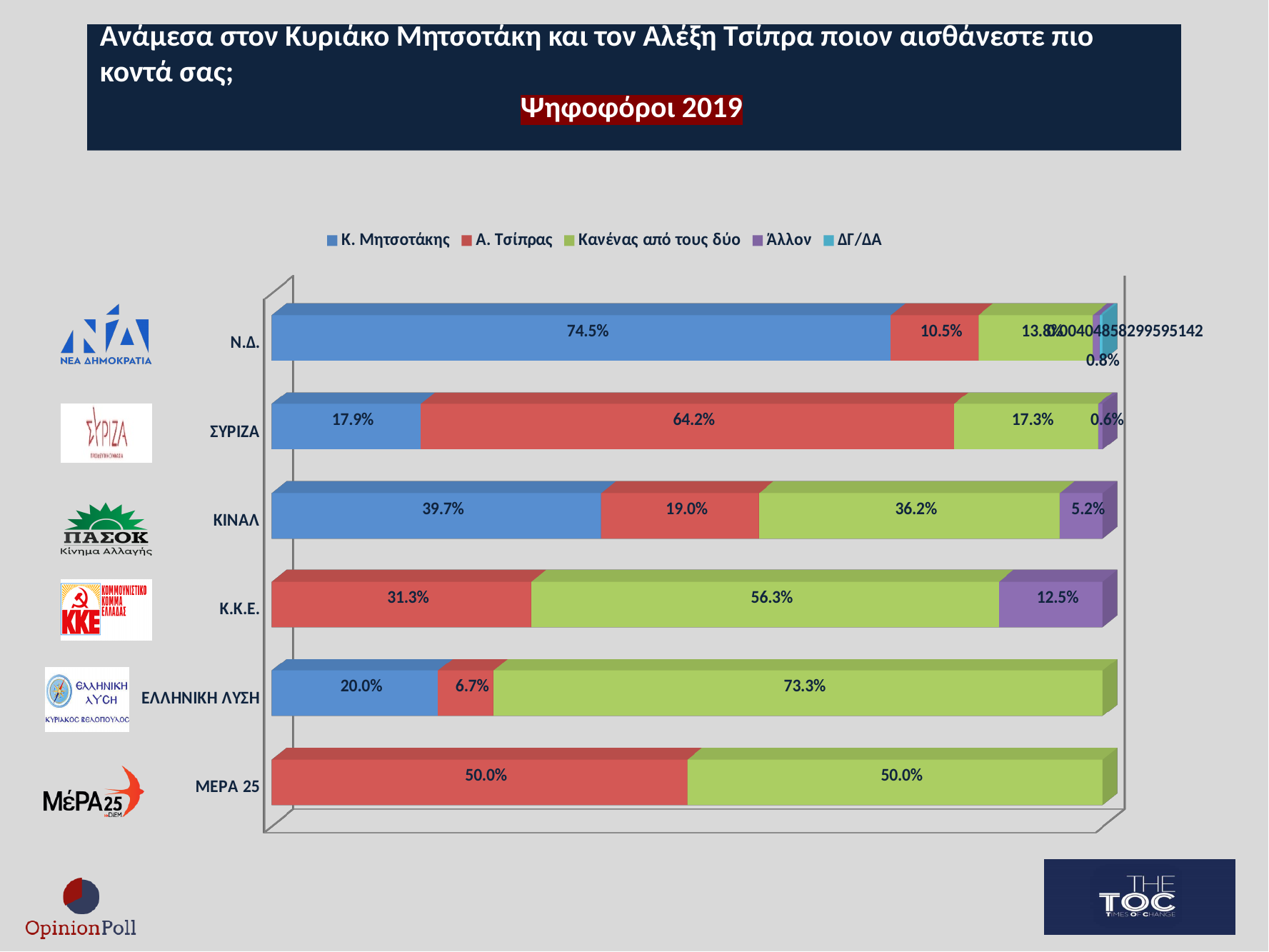
What is the value for Κανένας από τους δύο among ΕΛΛΗΝΙΚΗ ΛΥΣΗ voters? 73.3% What is the difference between the Κ. Μητσοτάκης and Α. Τσίπρας values among ΚΙΝΑΛ voters? 20.7% What is the value for Κ. Μητσοτάκης among Ν.Δ. voters? 74.5% What is the value for Α. Τσίπρας among ΣΥΡΙΖΑ voters? 64.2% What is the title shown in the red box below the question on the slide? Ψηφοφόροι 2019 Among Κ.Κ.Ε. voters, which is larger: the value for Α. Τσίπρας or for Κανένας από τους δύο? Κανένας από τους δύο Which party's voters have the highest value for Κ. Μητσοτάκης? Ν.Δ. Which party's voters have the lowest value for Α. Τσίπρας? ΕΛΛΗΝΙΚΗ ΛΥΣΗ How many series does the legend list? 5 What kind of chart is shown on the slide? stacked bar chart How many party categories are shown on the chart? 6 What is the value for Άλλον among Κ.Κ.Ε. voters? 12.5%